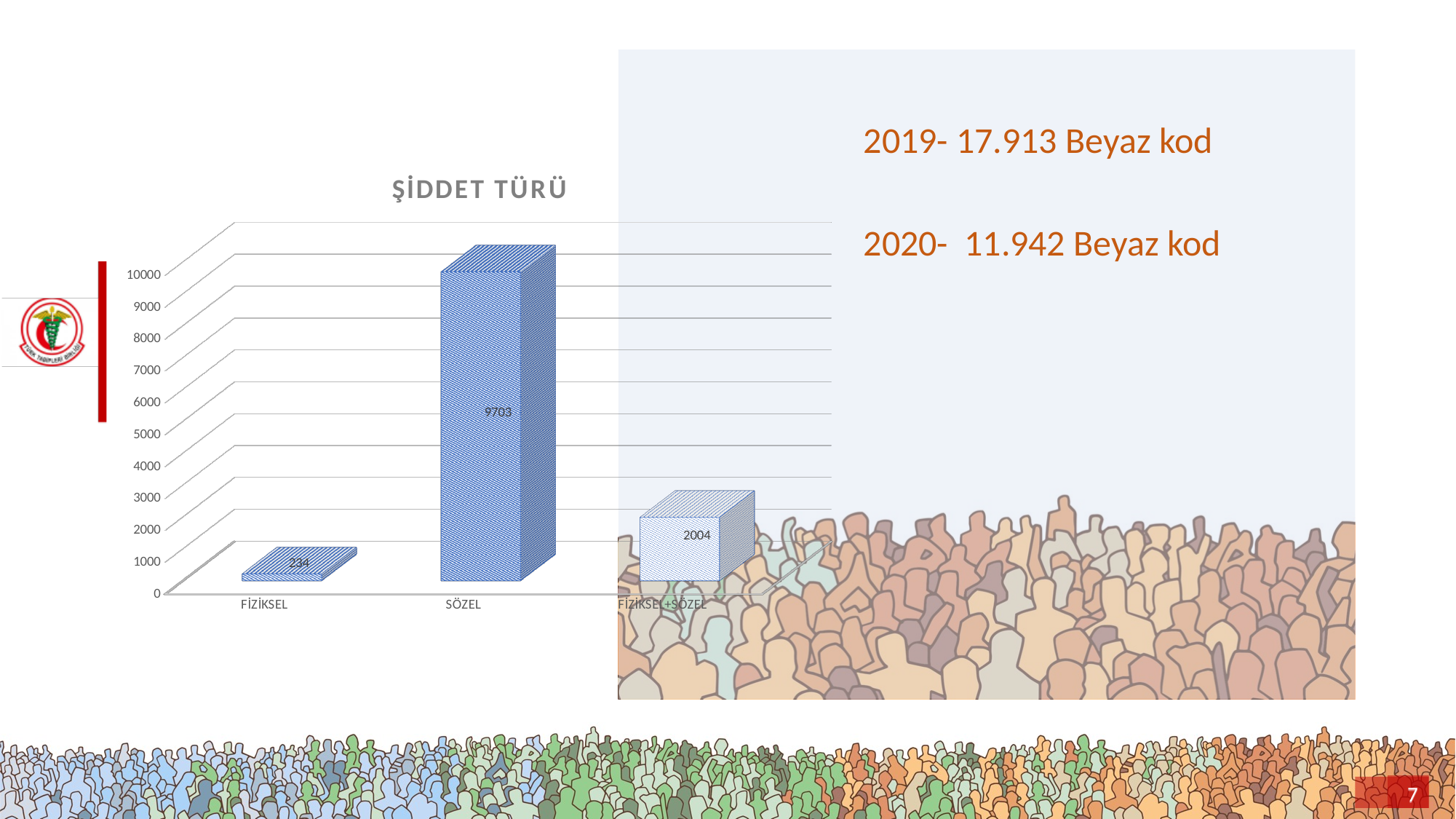
What is the difference between the values for SÖZEL and FİZİKSEL+SÖZEL? 7699 What is the value for SÖZEL? 9703 How many categories are shown on the x axis? 3 What is the value for FİZİKSEL? 234 What is the title of the chart? ŞİDDET TÜRÜ Which category has the lowest value? FİZİKSEL Which is larger, the value for FİZİKSEL or the value for FİZİKSEL+SÖZEL? FİZİKSEL+SÖZEL Which category has the highest value? SÖZEL What is the difference between the values for FİZİKSEL+SÖZEL and FİZİKSEL? 1770 What is the value for FİZİKSEL+SÖZEL? 2004 Is the value for SÖZEL greater or less than 9000? greater What kind of chart is shown on the slide? bar chart